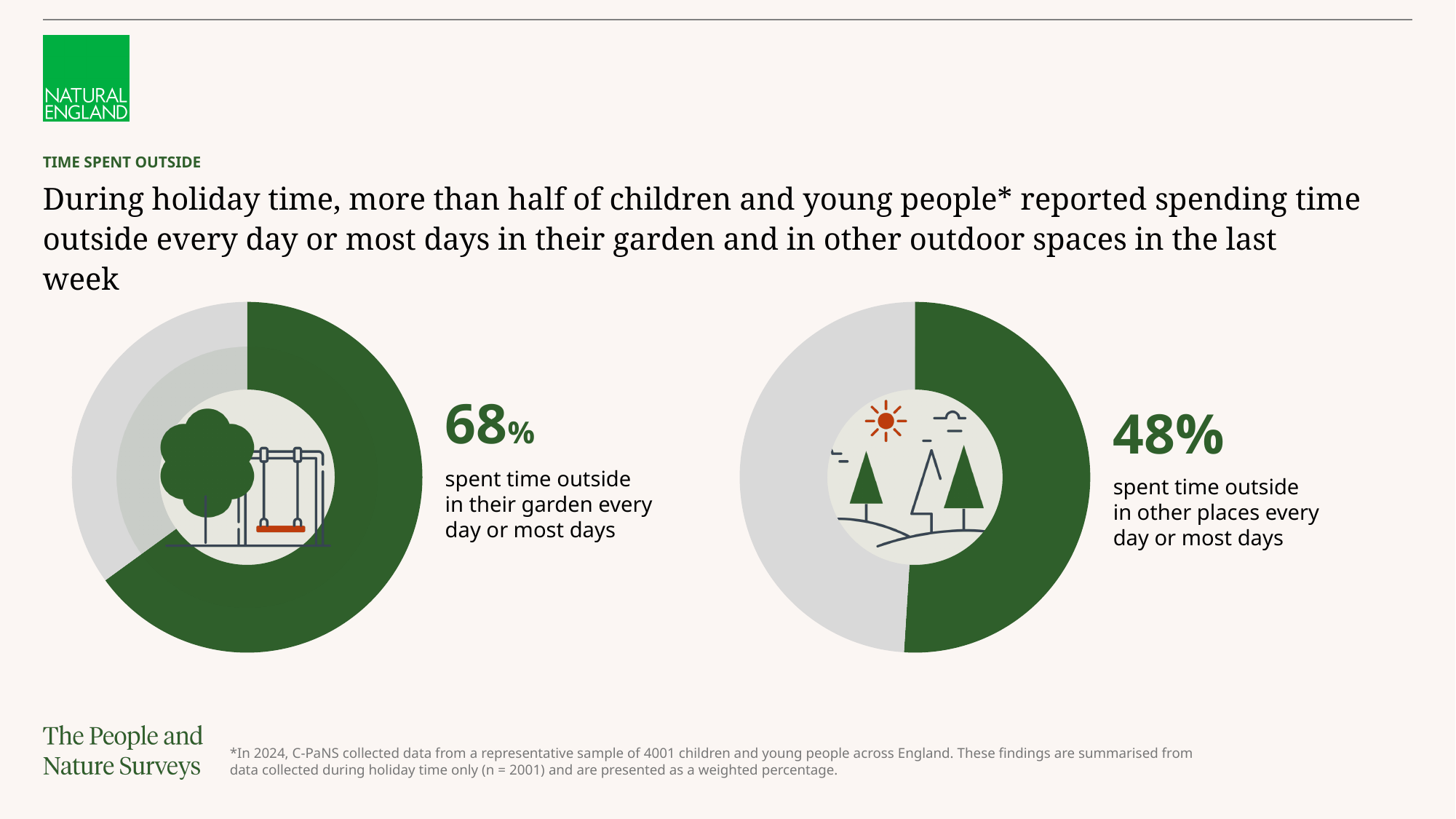
Which of the two donut charts has the larger highlighted (dark green) portion? The left chart (garden, 68%) On the right donut chart, what percentage of children and young people spent time outside in other places every day or most days? 48% How many donut charts are shown on the slide? 2 Which is larger: the share who spent time outside in their garden every day or most days, or the share who spent time outside in other places every day or most days? in their garden (68%) What colour is used for the highlighted portion of each donut chart? Dark green What is the difference in percentage points between the garden figure (68%) and the other places figure (48%)? 20 percentage points Which of the two donut charts has the smaller highlighted (dark green) portion? The right chart (other places, 48%) What kind of chart is used to show the 68% and 48% figures on this slide? Donut (pie) chart What is the section heading printed above the slide title? TIME SPENT OUTSIDE On the left donut chart, what percentage of children and young people spent time outside in their garden every day or most days? 68%